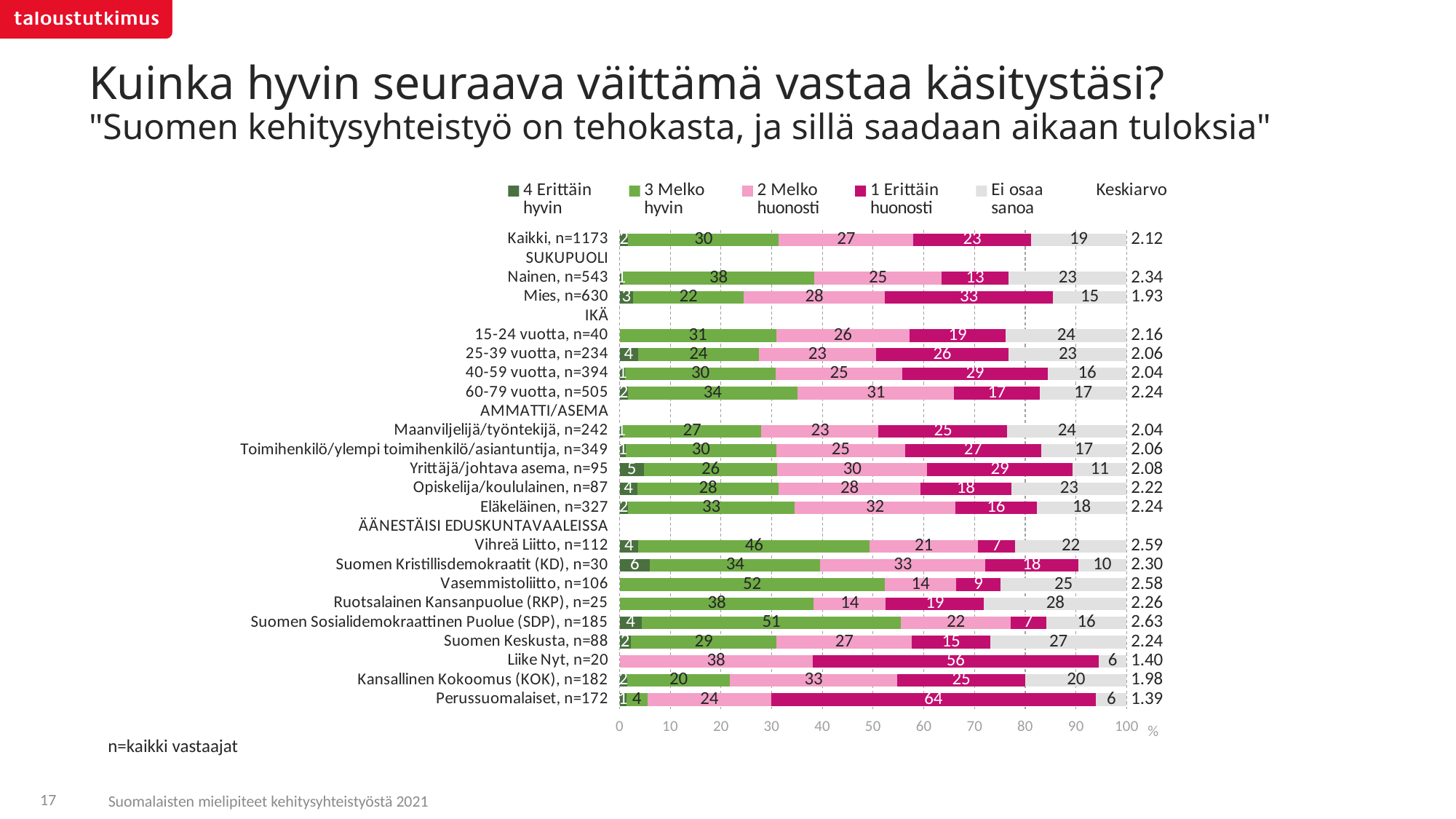
What is the Keskiarvo for Vihreä Liitto, n=112? 2.59 What is the value of "1 Erittäin huonosti" for Kaikki, n=1173? 23 Which category has the highest "1 Erittäin huonosti" value? Perussuomalaiset, n=172 What statement is quoted in the slide title that respondents were asked about? "Suomen kehitysyhteistyö on tehokasta, ja sillä saadaan aikaan tuloksia" What is the difference between the "1 Erittäin huonosti" values for Mies, n=630 and Nainen, n=543? 20 What is the "Ei osaa sanoa" value for Ruotsalainen Kansanpuolue (RKP), n=25? 28 Which has a larger "3 Melko hyvin" value: Vasemmistoliitto, n=106 or Vihreä Liitto, n=112? Vasemmistoliitto, n=106 What kind of chart is shown on the slide? bar chart Which category has the lowest Keskiarvo? Perussuomalaiset, n=172 Which category has the highest Keskiarvo? Suomen Sosialidemokraattinen Puolue (SDP), n=185 How many series does the chart legend list (excluding the Keskiarvo column)? 5 What is the value of "1 Erittäin huonosti" for Perussuomalaiset, n=172? 64